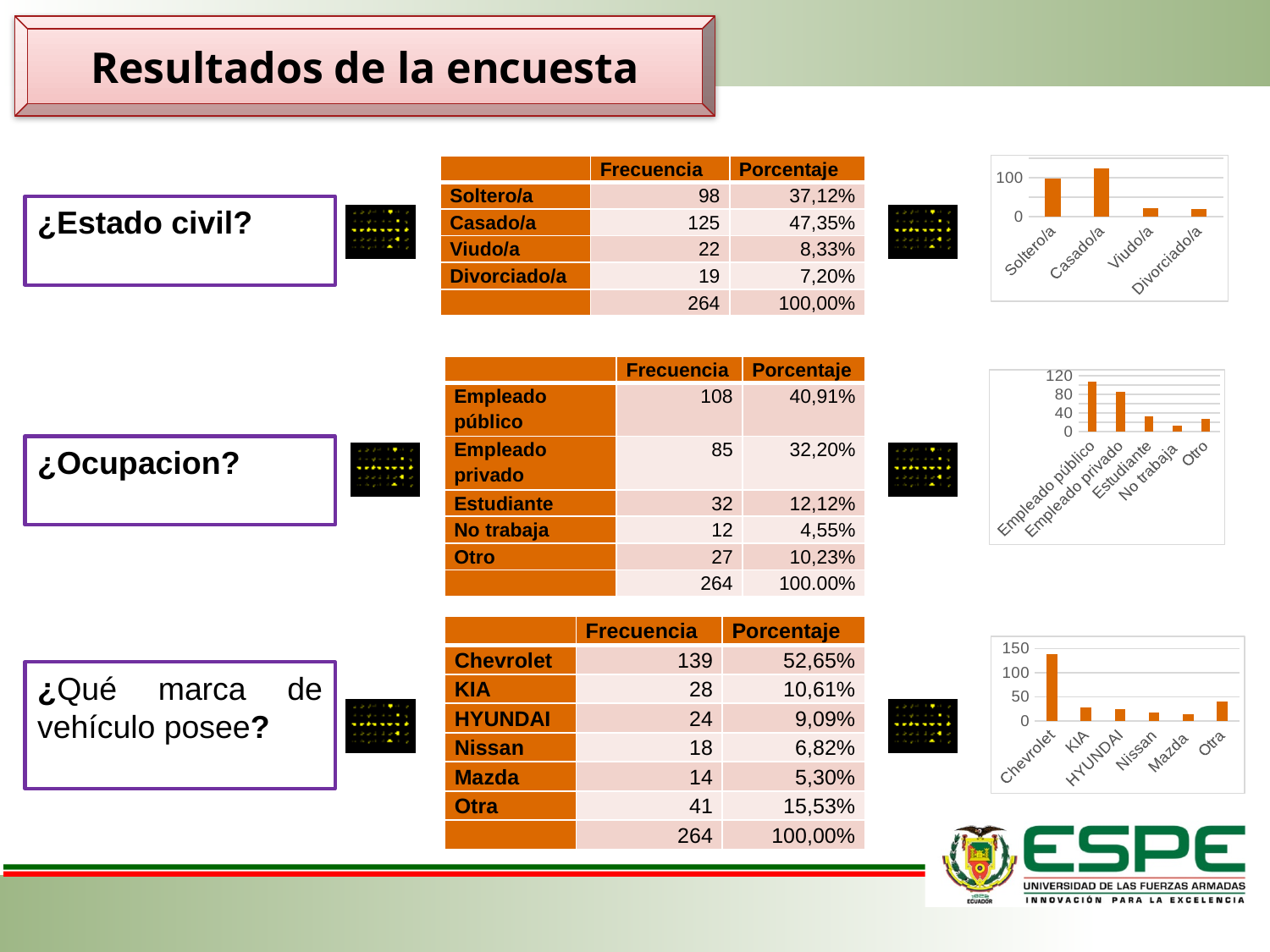
In the middle-right chart, is the value for Estudiante greater or less than 40? less In the top-right chart, which category has the highest bar? Casado/a In the bottom-right chart, which category has the highest bar? Chevrolet In the bottom-right chart, is the value for Chevrolet greater or less than 100? greater In the middle-right chart, is the value for Empleado privado greater or less than 80? greater What kind of chart is the top-right chart on the slide? bar chart How many categories does the bottom-right chart (marca de vehículo) show? 6 How many categories does the middle-right chart (ocupación) show? 5 In the top-right chart, which is larger, Viudo/a or Divorciado/a? Viudo/a How many categories does the top-right chart (estado civil) show? 4 In the middle-right chart, which category has the lowest bar? No trabaja